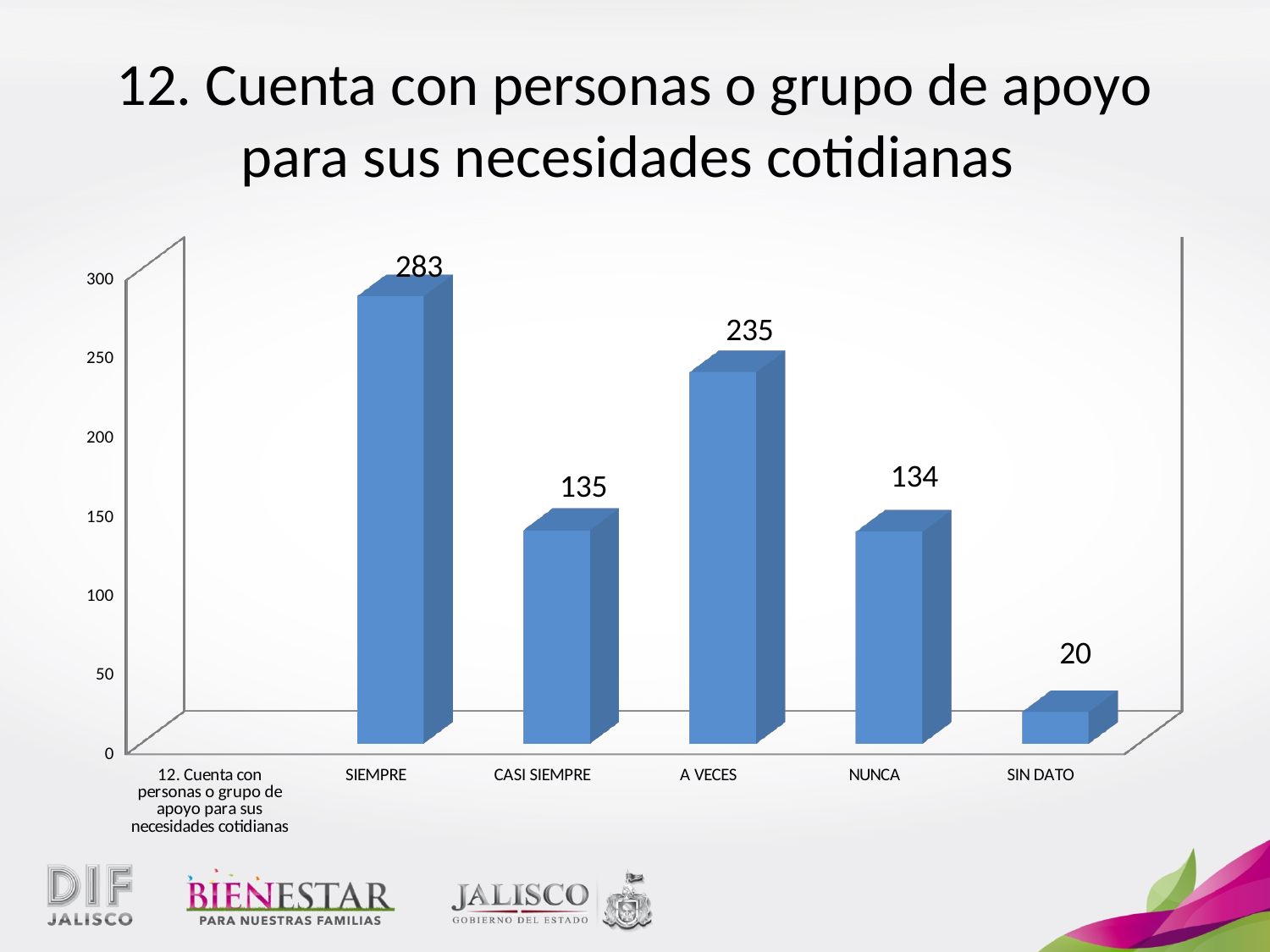
What is the value for SIEMPRE? 283 Which category has the lowest value? SIN DATO Is the value for SIEMPRE greater or less than 250? greater How many bars are plotted in the chart? 5 What is the value for SIN DATO? 20 Which is larger, the value for A VECES or the value for NUNCA? A VECES Which category has the highest value? SIEMPRE What is the difference between the values for SIEMPRE and A VECES? 48 What kind of chart is shown on the slide? bar chart What is the value for A VECES? 235 What is the value for CASI SIEMPRE? 135 What is the difference between the values for A VECES and CASI SIEMPRE? 100